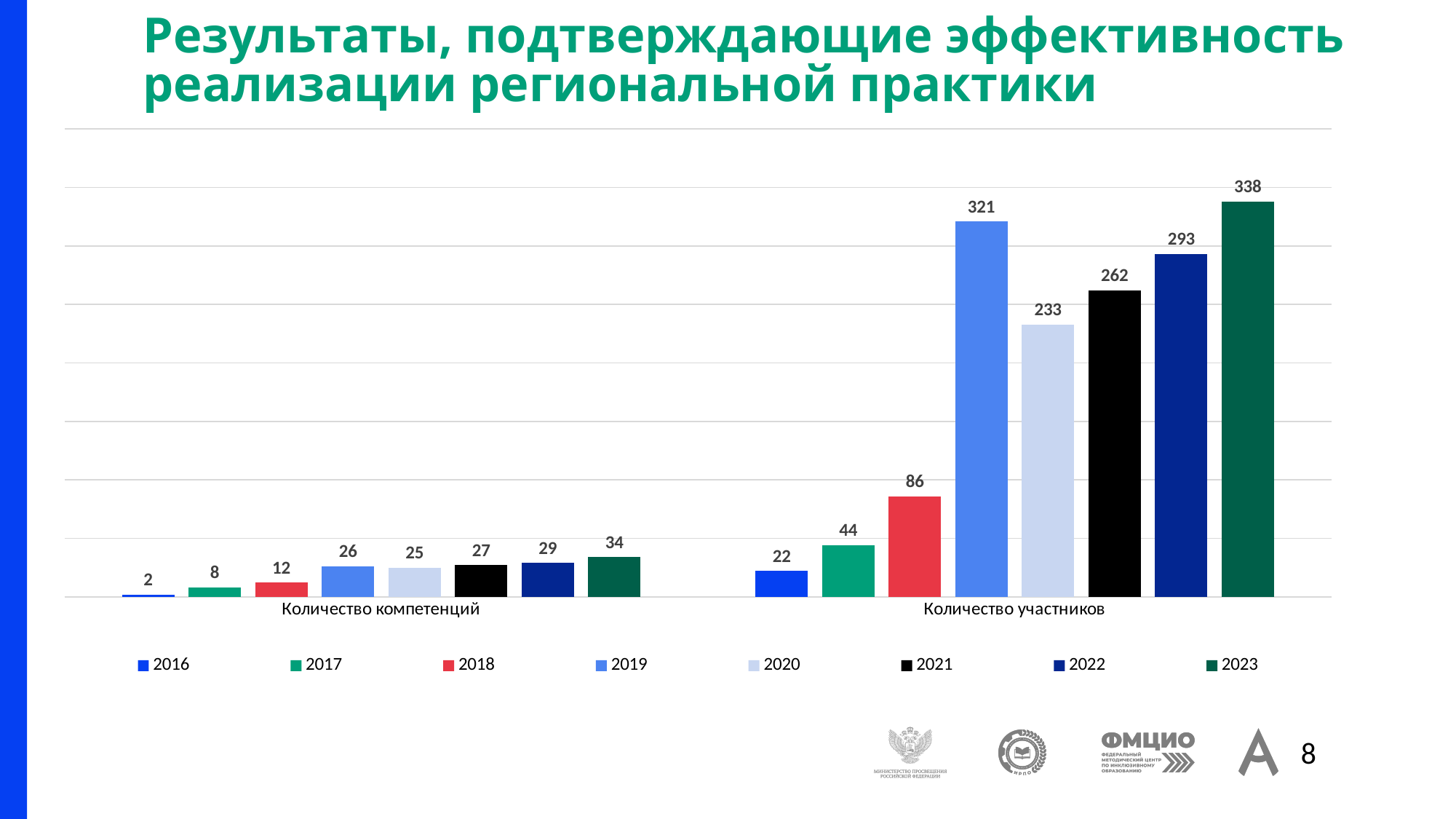
Which is larger in the category Количество участников: the value for 2019 or the value for 2022? 2019 What is the value for 2019 in the category Количество компетенций? 26 What is the difference between the 2023 and 2016 values in the category Количество участников? 316 What kind of chart is shown on the slide? bar chart How many categories are shown on the x axis? 2 Which year has the lowest value in the category Количество компетенций? 2016 What is the value for 2018 in the category Количество участников? 86 What is the value for 2023 in the category Количество участников? 338 What is the difference between the 2019 and 2020 values in the category Количество участников? 88 Which year is shown in red in the legend? 2018 Which year has the highest value in the category Количество участников? 2023 How many series does the legend list? 8